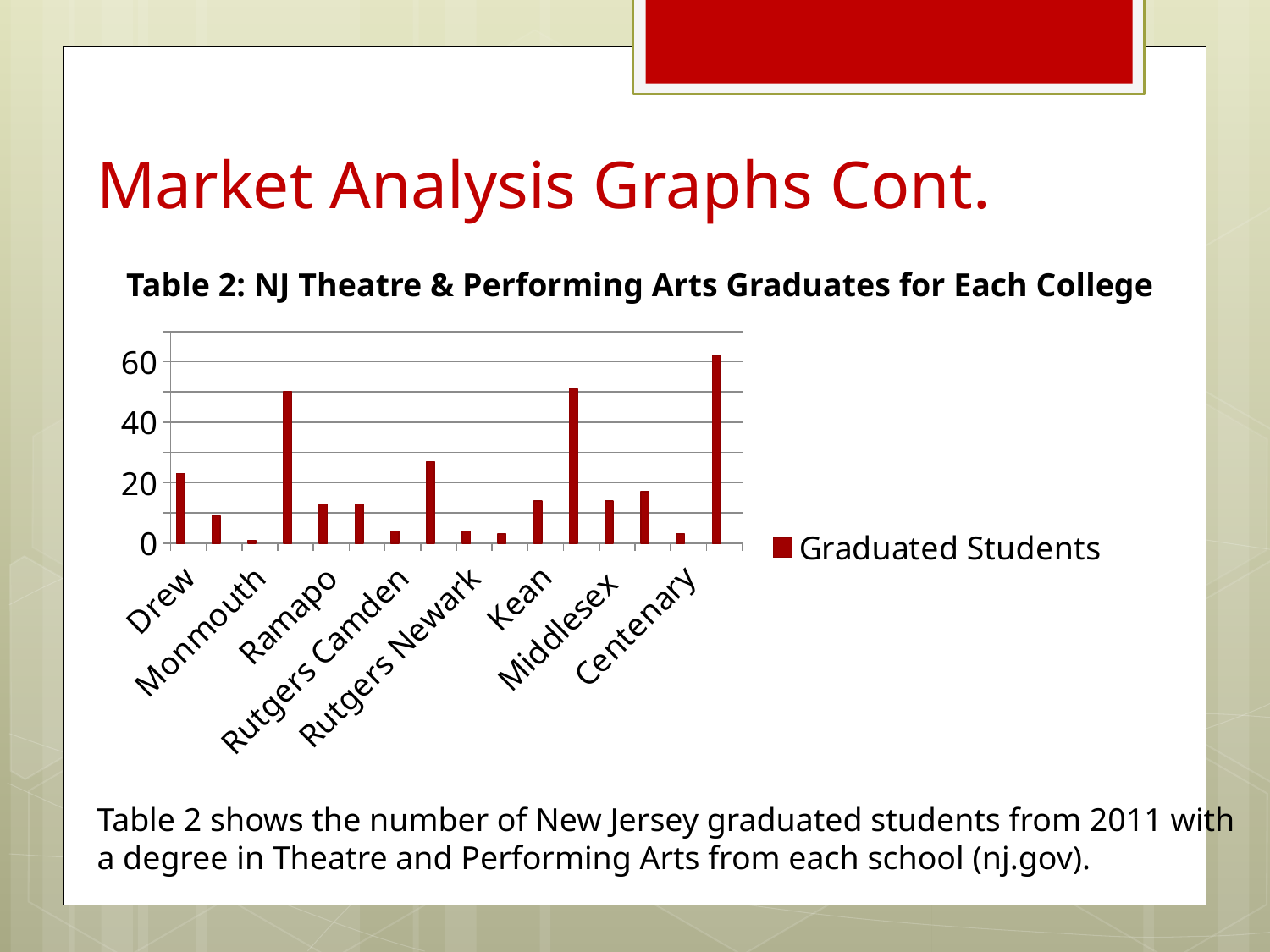
What kind of chart is shown on the slide? bar chart Is the value for Monmouth greater or less than 20? less How many series does the legend list? 1 What is the title of the chart? Table 2: NJ Theatre & Performing Arts Graduates for Each College Is the value for Rutgers Camden greater or less than 20? less How many bars are plotted in the chart? 16 Which has more graduated students, Drew or Monmouth? Drew Which has more graduated students, Drew or Kean? Drew What is the legend entry for the series in the chart? Graduated Students Is the value for Kean greater or less than 20? less Which has more graduated students, Ramapo or Monmouth? Ramapo